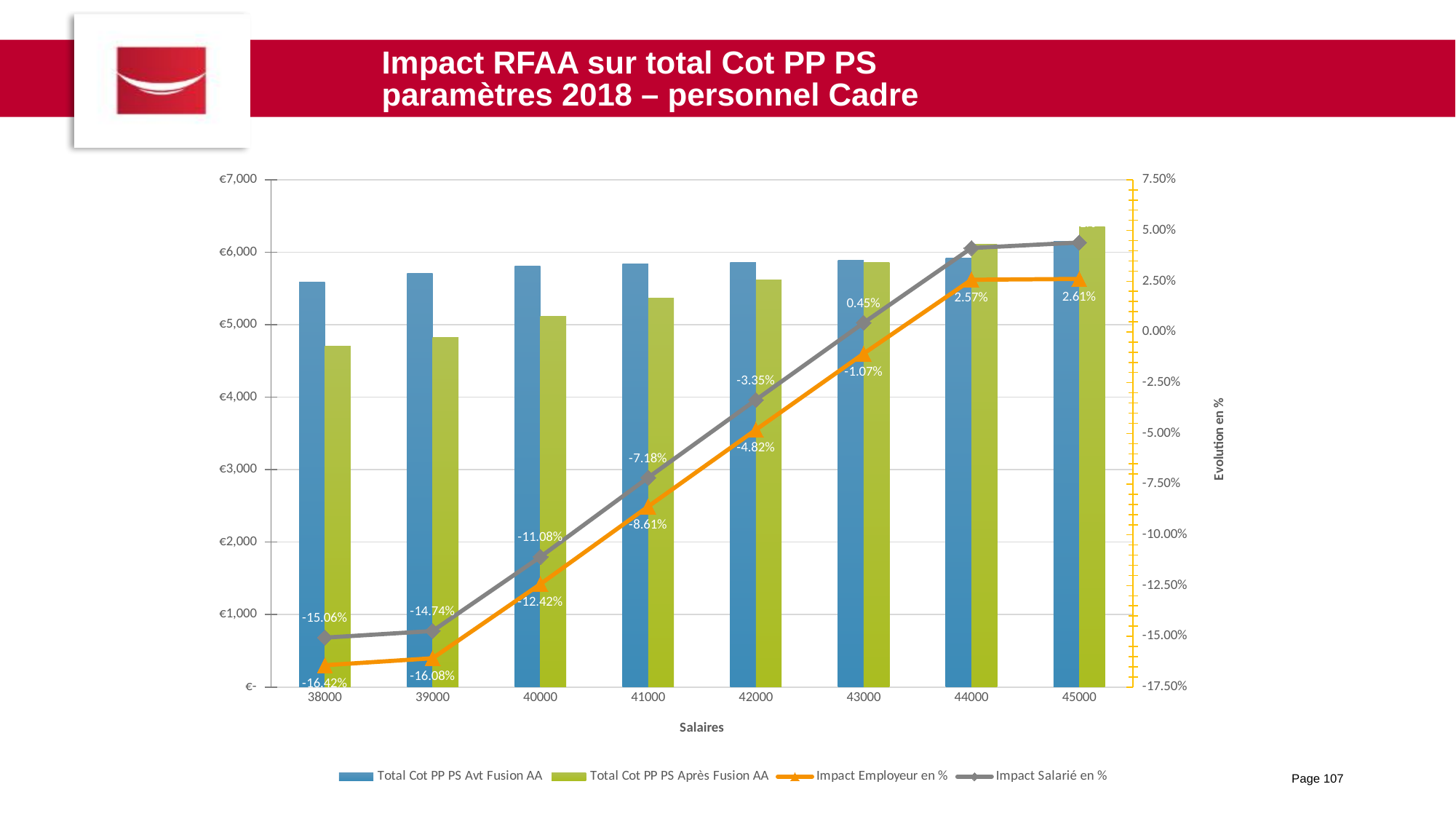
How many salary categories are shown on the x axis? 8 What is the value of Impact Employeur en % at a salary of 38000? -16.42% At a salary of 38000, which bar is taller: Total Cot PP PS Avt Fusion AA or Total Cot PP PS Après Fusion AA? Total Cot PP PS Avt Fusion AA Do the Total Cot PP PS Après Fusion AA bars rise or fall as salary increases? rise How many series does the legend list? 4 Is the value of Total Cot PP PS Après Fusion AA at a salary of 38000 greater or less than €5,000? less What is the difference between Impact Employeur en % at 45000 and at 44000? 0.04 percentage points At which salary is Impact Employeur en % lowest? 38000 What is the value of Impact Salarié en % at a salary of 43000? 0.45% What is the value of Impact Employeur en % at a salary of 45000? 2.61% Is the value of Total Cot PP PS Après Fusion AA at a salary of 45000 greater or less than €6,000? greater What is the difference between Impact Salarié en % and Impact Employeur en % at a salary of 38000? 1.36 percentage points